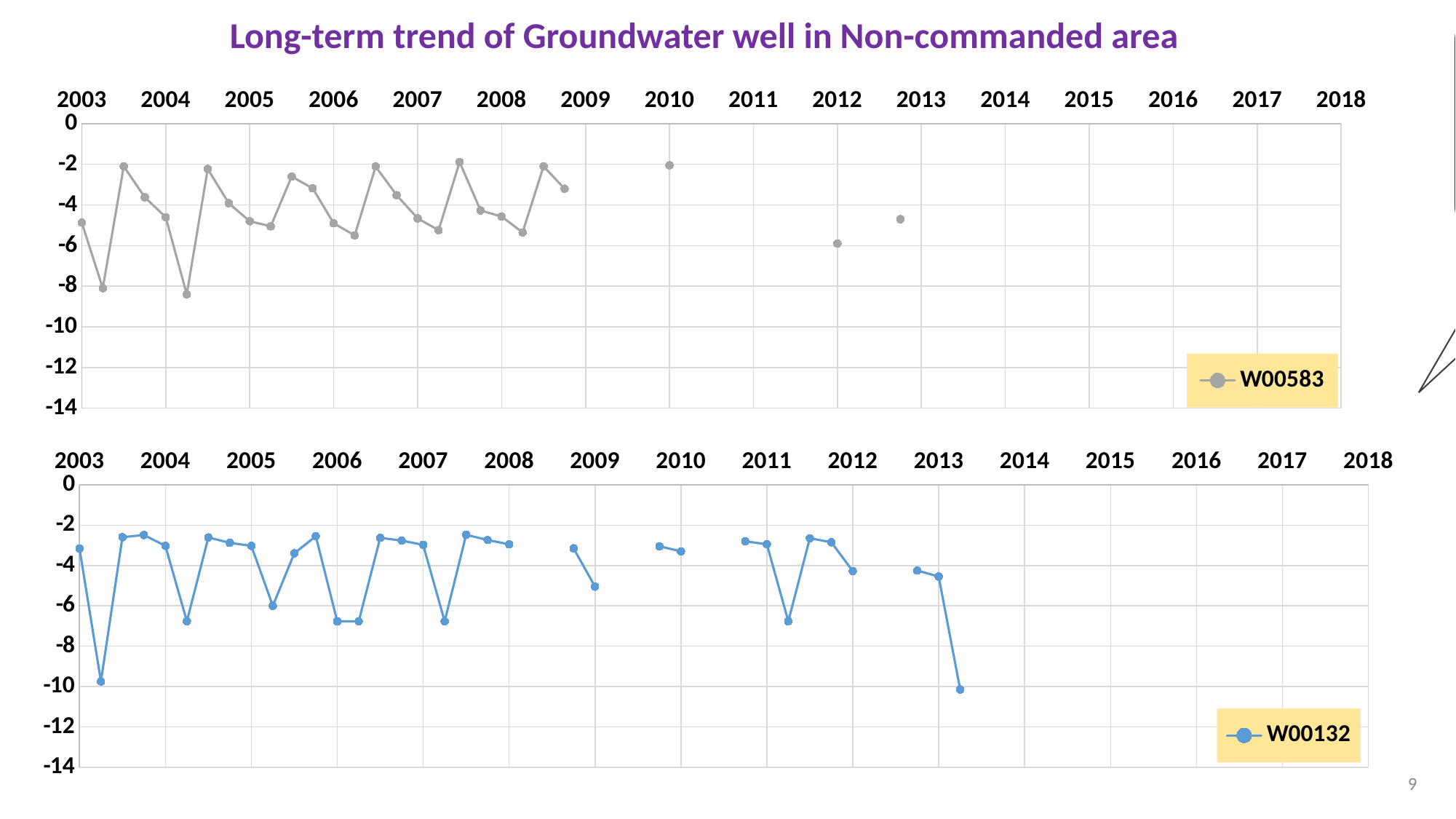
How many series does the legend of the top chart list? 1 What is the last year shown on the x axis of the bottom chart? 2018 In the bottom chart (W00132), is the lowest value plotted in 2011 greater or less than -4? less What is the series name shown in the legend of the top chart? W00583 What kind of chart is the bottom chart on the slide? line chart In the bottom chart (W00132), is the first value plotted in 2003 greater or less than -6? greater In the bottom chart (W00132), is the lowest value plotted in 2013 greater or less than -8? less What kind of chart is the top chart on the slide? line chart What is the series name shown in the legend of the bottom chart? W00132 Which well reaches the lower minimum value across the two charts, W00583 or W00132? W00132